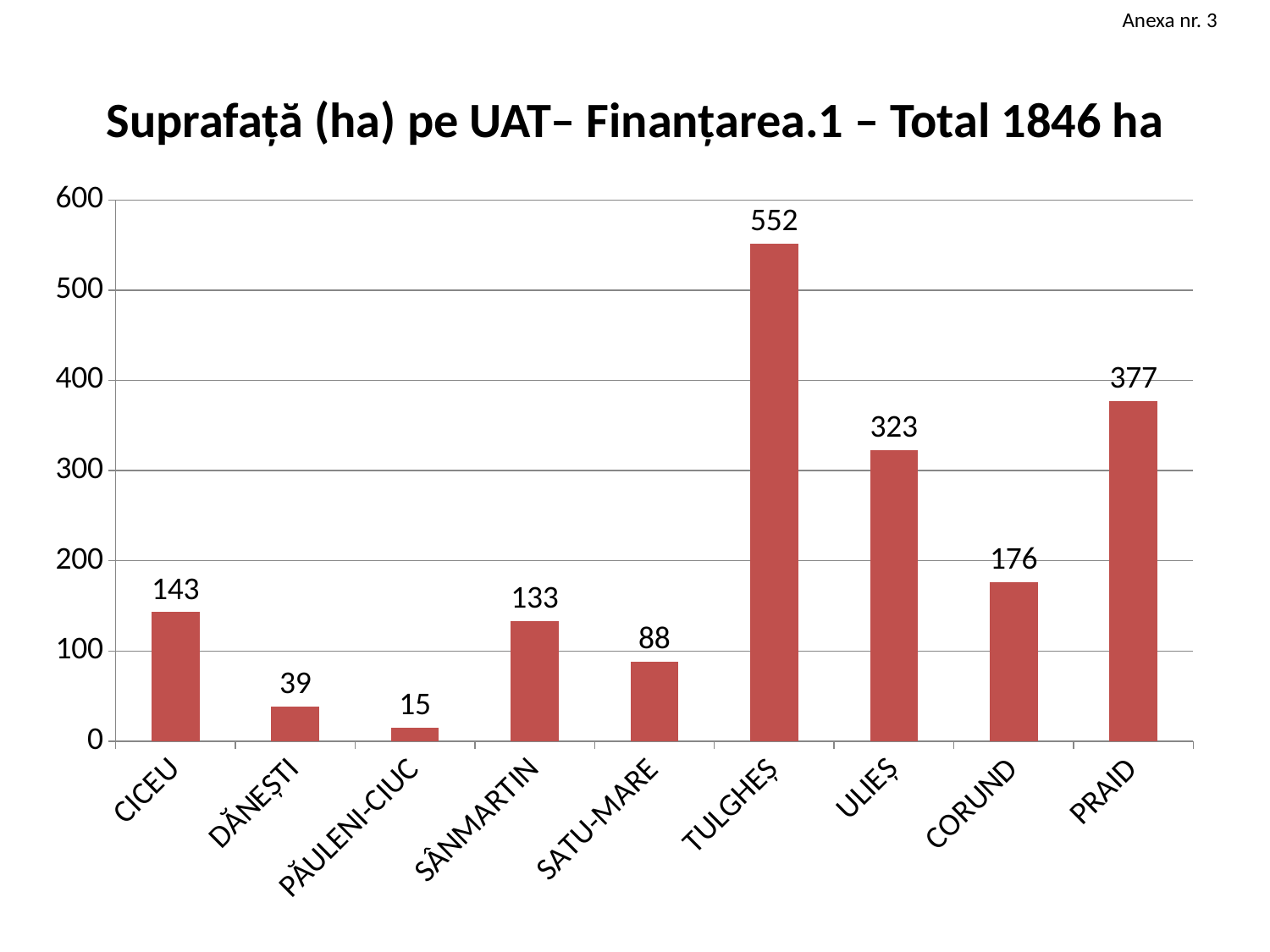
What is the title of the chart? Suprafață (ha) pe UAT– Finanțarea.1 – Total 1846 ha What kind of chart is shown on the slide? bar chart What is the value for PĂULENI-CIUC? 15 How many categories are shown on the x axis? 9 What is the difference between the values for PRAID and ULIEȘ? 54 Which category has the highest value? TULGHEȘ Which is larger, the value for SATU-MARE or the value for DĂNEȘTI? SATU-MARE Is the value for ULIEȘ greater or less than 300? greater What is the value for CORUND? 176 What is the value for TULGHEȘ? 552 Which category has the lowest value? PĂULENI-CIUC What is the difference between the values for CICEU and SÂNMARTIN? 10